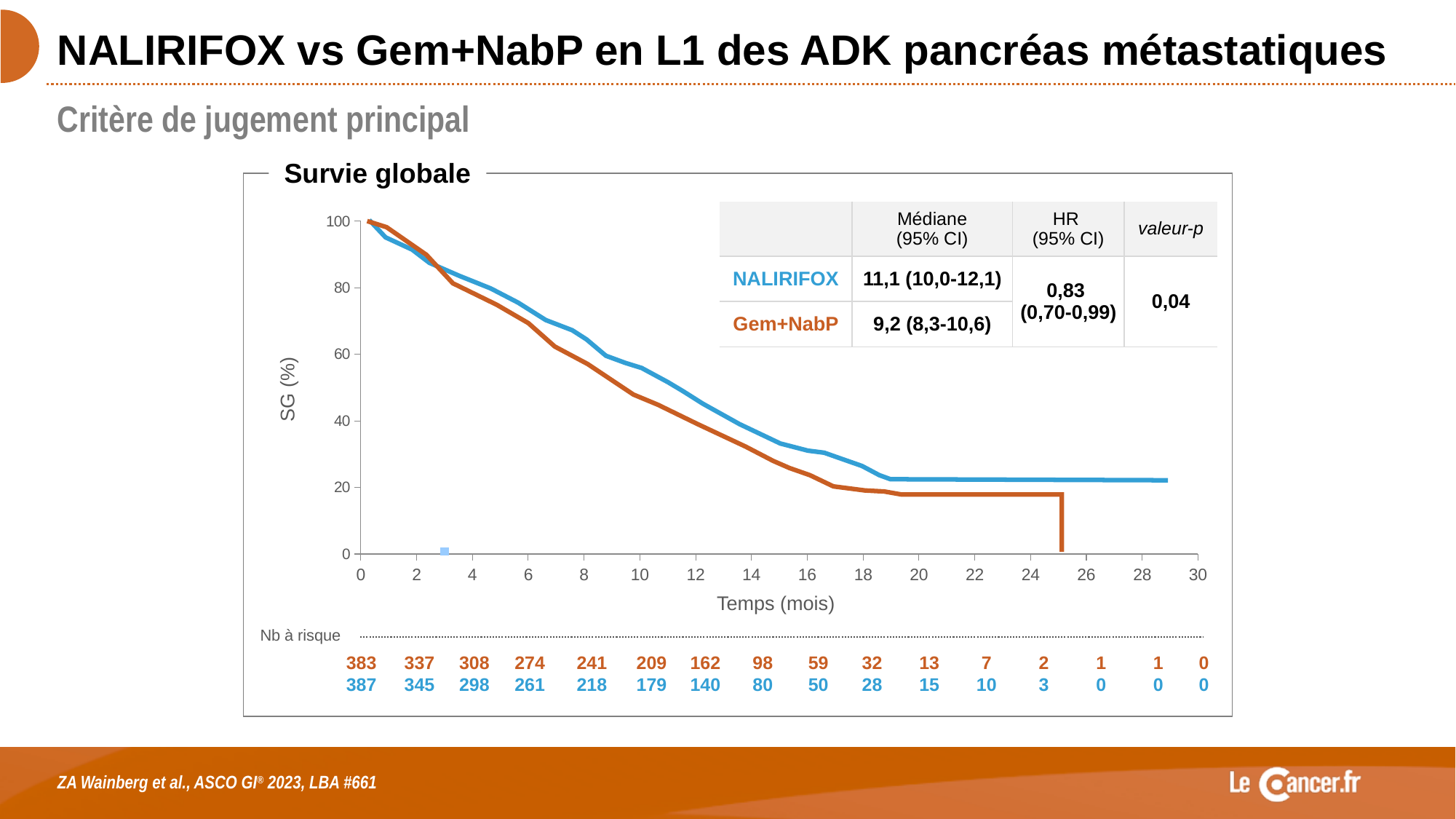
What is the median overall survival (Médiane) for Gem+NabP shown in the table? 9,2 (8,3-10,6) How many patients were at risk in the NALIRIFOX arm (blue row) at time 0? 387 What is the p-value (valeur-p) shown in the table? 0,04 How many treatment arms (series) are plotted on the survival chart? 2 Is the survival value of the Gem+NabP (orange) curve at 10 months greater or less than 60%? less Do the survival curves rise or fall as time (Temps) increases along the x axis? fall What is the hazard ratio (HR) with its 95% CI shown in the table? 0,83 (0,70-0,99) What is the difference between the median overall survival of NALIRIFOX and Gem+NabP (in months)? 1,9 What is the median overall survival (Médiane) for NALIRIFOX shown in the table? 11,1 (10,0-12,1) What kind of chart is shown under the title "Survie globale"? line chart How many patients were at risk in the Gem+NabP arm (orange row) at 12 months? 162 Which treatment arm has the higher median overall survival? NALIRIFOX